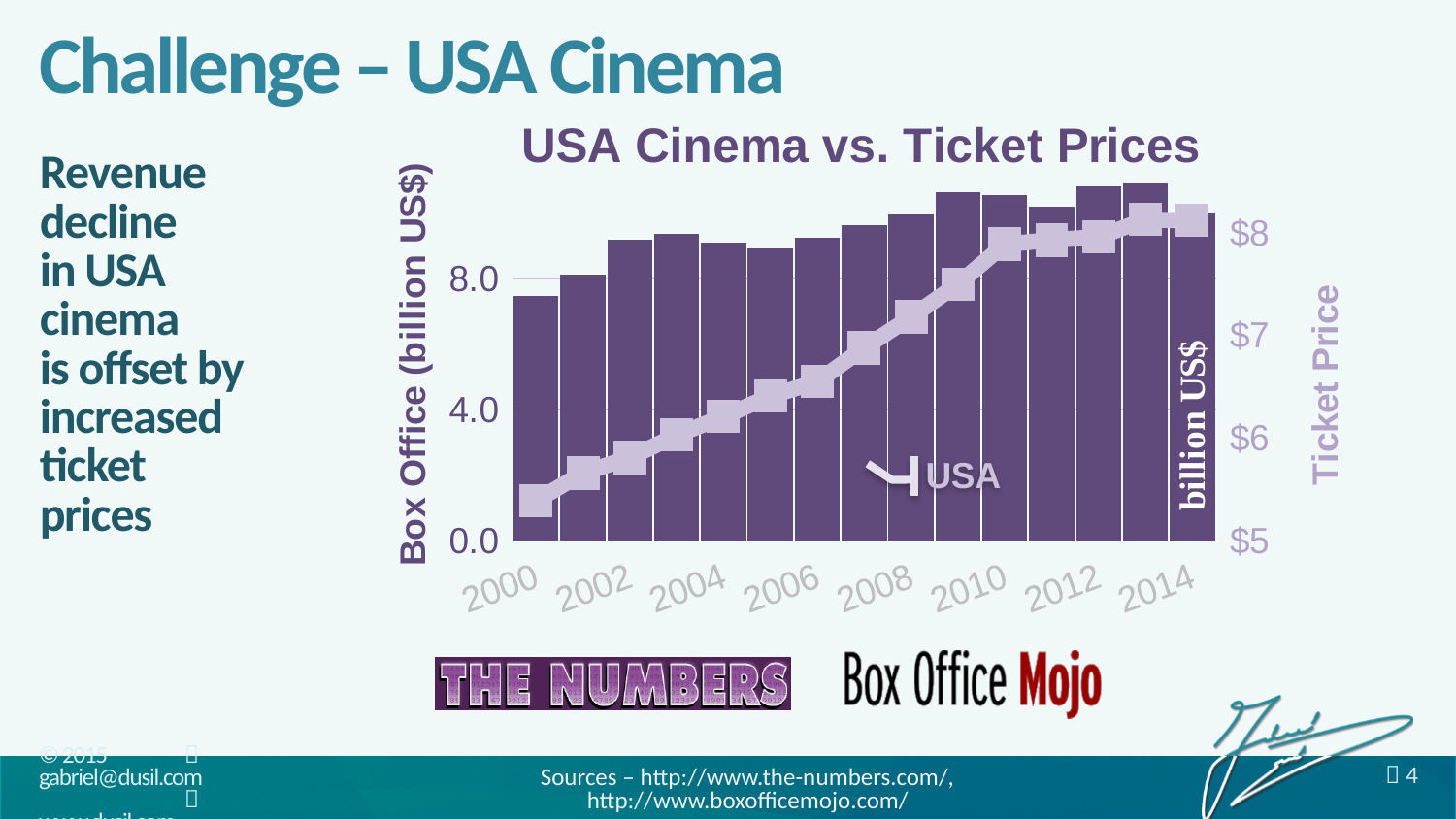
Which year has the higher ticket price, 2002 or 2008? 2008 What is the title of the chart? USA Cinema vs. Ticket Prices What is the label of the left vertical axis? Box Office (billion US$) Which year has the larger box office value, 2000 or 2010? 2010 Is the box office value for 2000 greater or less than 8.0 billion US$? less Is the ticket price for 2000 greater or less than $6? less What type of chart is shown on the slide? Combined bar and line chart Is the ticket price for 2010 greater or less than $7? greater Which year has the lowest ticket price? 2000 Which year has the lowest box office value? 2000